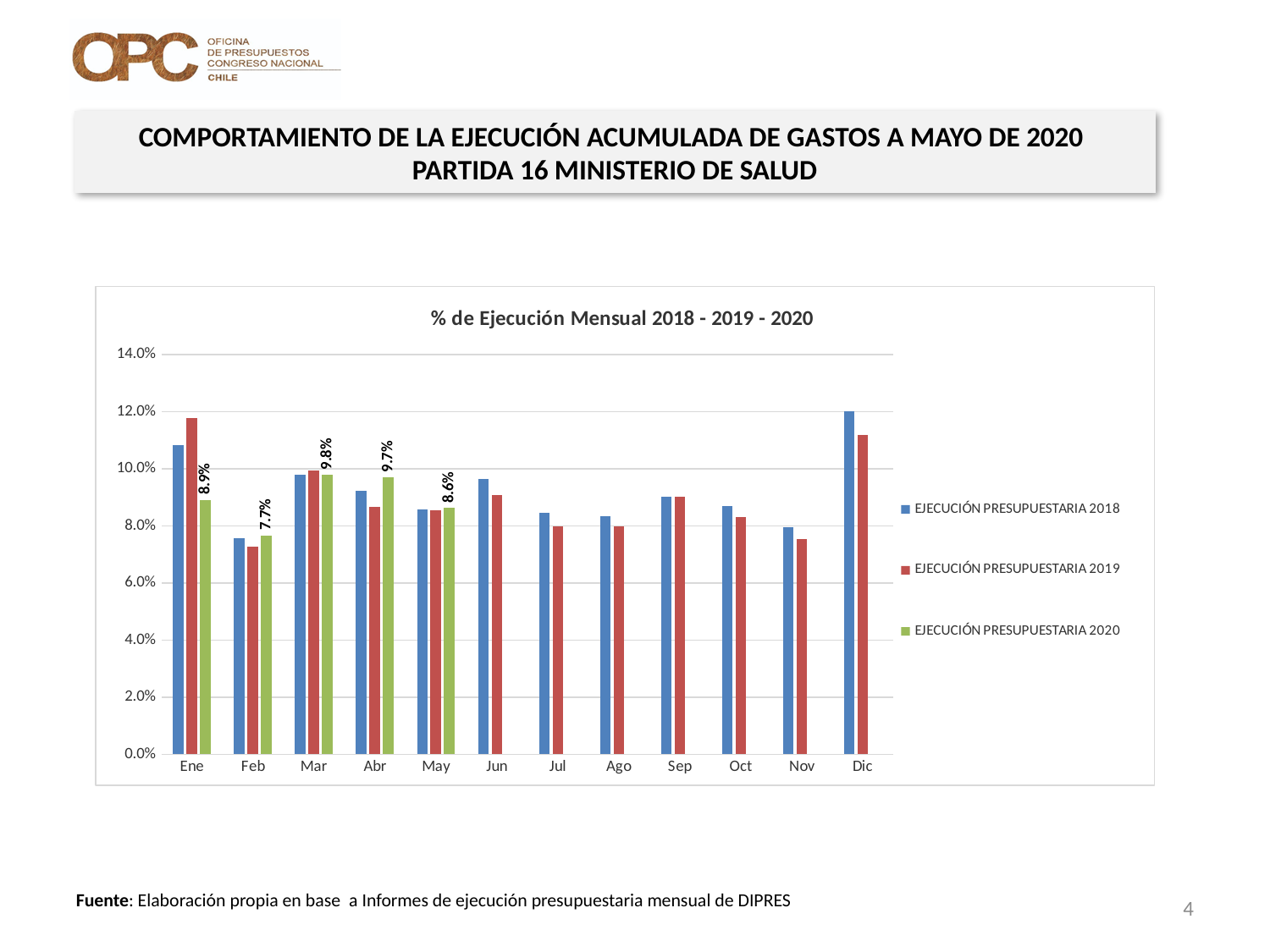
Which month has the lowest value for EJECUCIÓN PRESUPUESTARIA 2020? Feb Which is larger for EJECUCIÓN PRESUPUESTARIA 2020: Ene or May? Ene What is the value for EJECUCIÓN PRESUPUESTARIA 2020 in Ene? 8.9% Which month has the highest value for EJECUCIÓN PRESUPUESTARIA 2020? Mar What is the value for EJECUCIÓN PRESUPUESTARIA 2020 in Feb? 7.7% What is the value for EJECUCIÓN PRESUPUESTARIA 2020 in May? 8.6% How many series does the legend list? 3 What is the value for EJECUCIÓN PRESUPUESTARIA 2020 in Mar? 9.8% What kind of chart is shown on the slide? Bar chart Is the value for EJECUCIÓN PRESUPUESTARIA 2019 in Nov greater or less than 8.0%? less Is the value for EJECUCIÓN PRESUPUESTARIA 2019 in Ene greater or less than 10.0%? greater What is the difference between the EJECUCIÓN PRESUPUESTARIA 2020 values for Mar and Feb? 2.1 percentage points